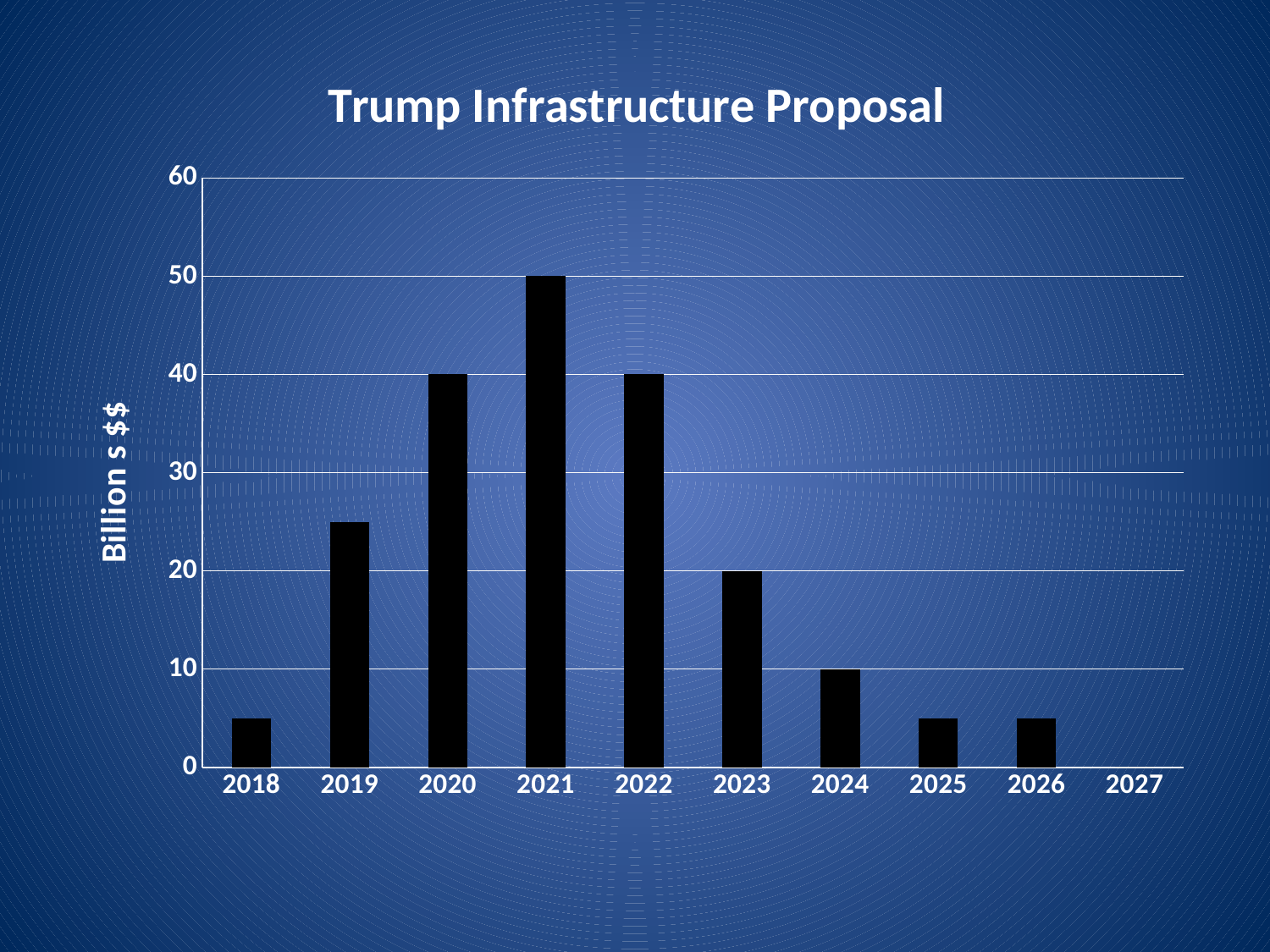
Is the value for 2018 greater or less than 10? less What is the value for 2021? 50 How many years are shown on the x axis? 10 Which is larger, the value for 2019 or the value for 2023? 2019 Which year has the highest value? 2021 What is the value for 2020? 40 Is the value for 2019 greater or less than 20? greater What is the value for 2023? 20 What is the difference between the values for 2021 and 2023? 30 What is the difference between the values for 2021 and 2020? 10 What kind of chart is this? bar chart What is the value for 2024? 10